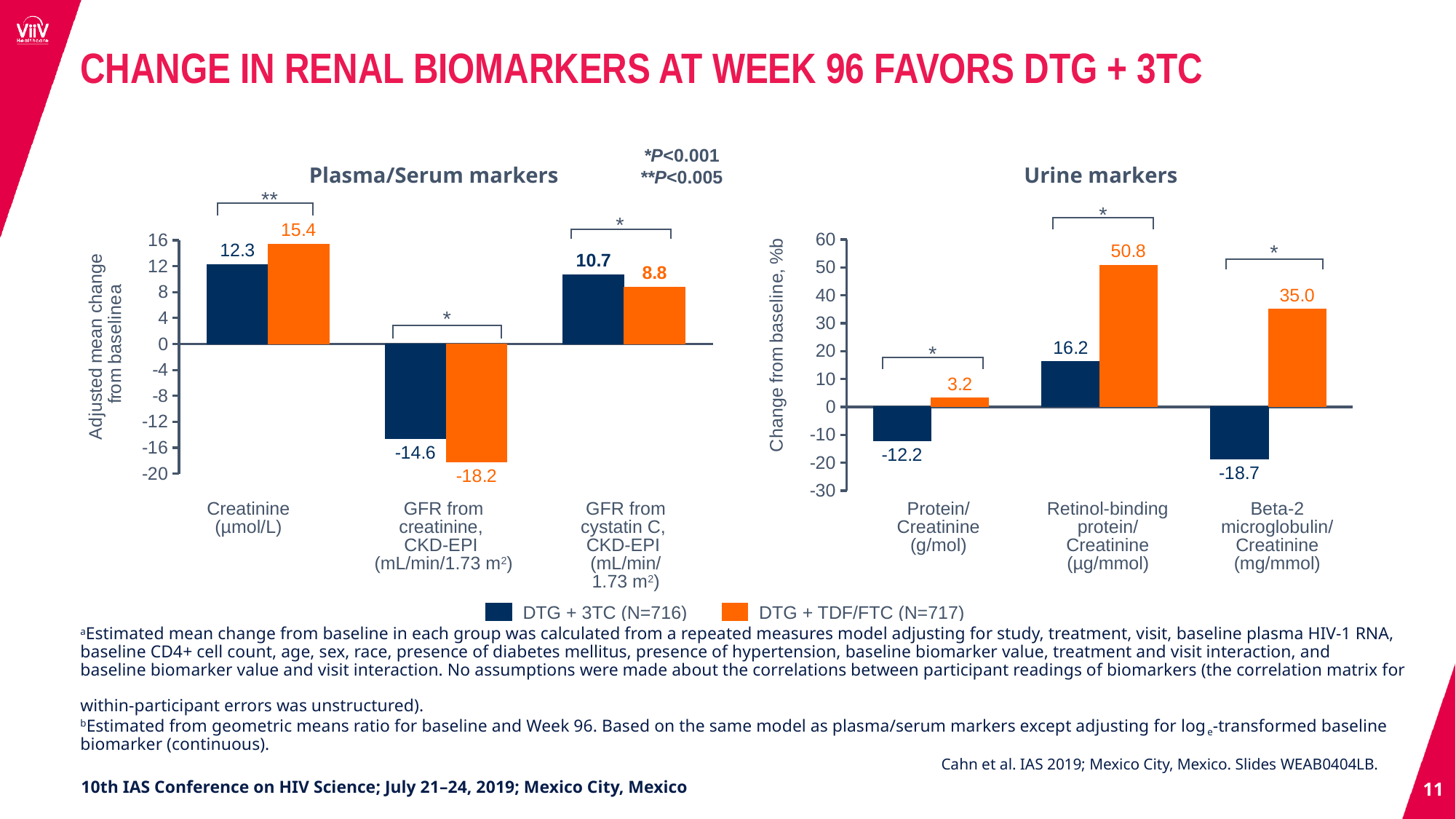
How many categories are shown in the Urine markers chart? 3 In the Urine markers chart, what is the value for DTG + 3TC for Beta-2 microglobulin/Creatinine? -18.7 In the Plasma/Serum markers chart, what is the value for DTG + 3TC for Creatinine (µmol/L)? 12.3 In the Urine markers chart, which category has the highest DTG + TDF/FTC value? Retinol-binding protein/Creatinine In the Plasma/Serum markers chart, which category has the lowest DTG + 3TC value? GFR from creatinine, CKD-EPI In the Plasma/Serum markers chart, what is the difference between the DTG + TDF/FTC and DTG + 3TC values for Creatinine? 3.1 In the Plasma/Serum markers chart, which is larger for GFR from cystatin C, CKD-EPI: DTG + 3TC or DTG + TDF/FTC? DTG + 3TC What kind of chart is the Plasma/Serum markers chart? Bar chart In the Plasma/Serum markers chart, what is the value for DTG + TDF/FTC for GFR from creatinine, CKD-EPI? -18.2 In the Urine markers chart, what is the value for DTG + TDF/FTC for Retinol-binding protein/Creatinine? 50.8 In the Urine markers chart, what is the difference between the DTG + TDF/FTC and DTG + 3TC values for Protein/Creatinine? 15.4 How many series does the legend list? 2